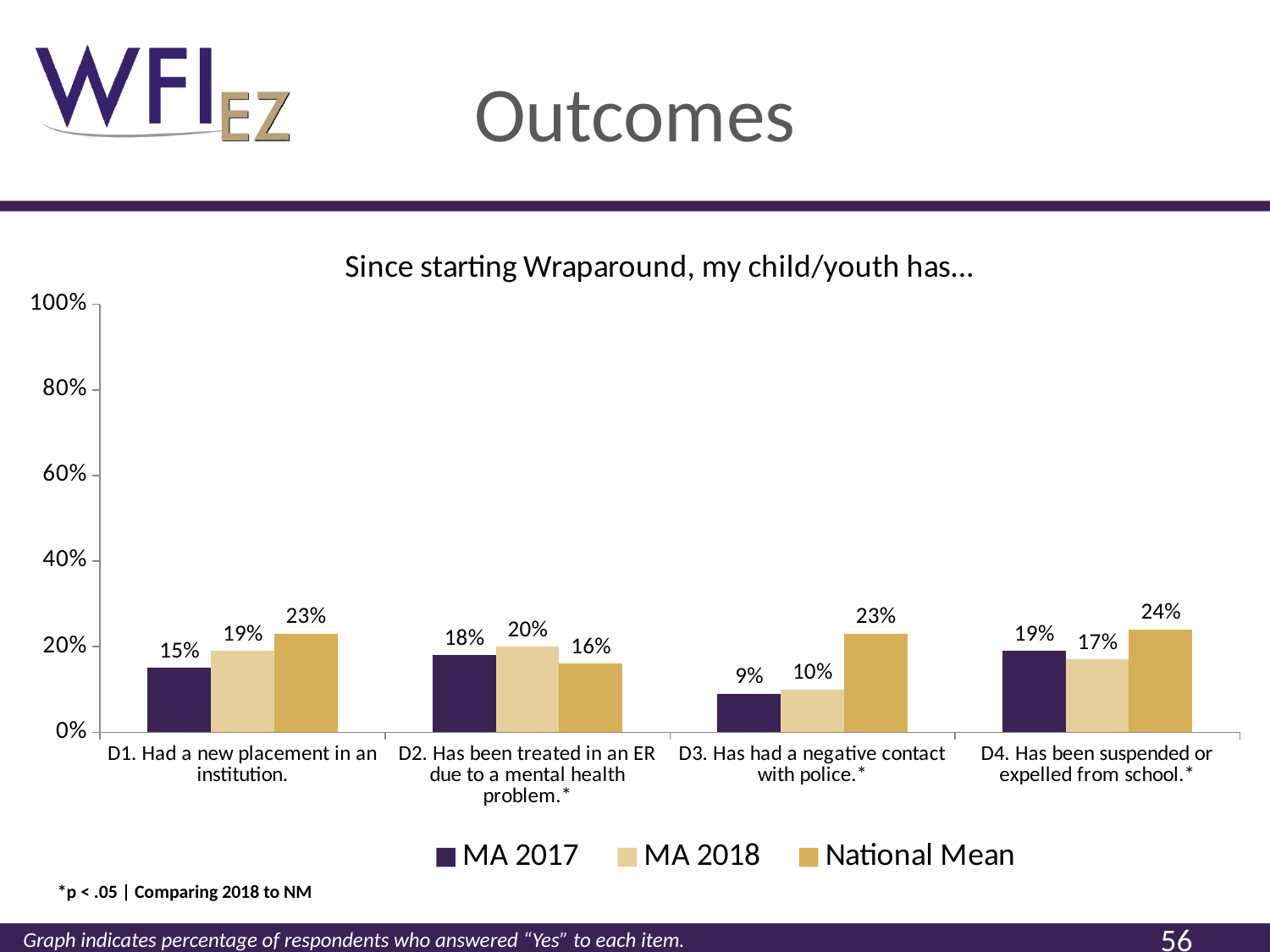
Which category has the highest National Mean value? D4. Has been suspended or expelled from school. How many categories are shown on the x axis? 4 What is the National Mean value for D3. Has had a negative contact with police? 23% What kind of chart is shown on the slide? Bar chart For D2. Has been treated in an ER due to a mental health problem, which is larger: MA 2018 or National Mean? MA 2018 What is the difference between the National Mean and MA 2018 values for D3. Has had a negative contact with police? 13% Is the MA 2017 value for D3. Has had a negative contact with police greater or less than 20%? less What is the title of the chart? Since starting Wraparound, my child/youth has... Which category has the lowest MA 2017 value? D3. Has had a negative contact with police. How many series does the legend list? 3 What is the MA 2017 value for D1. Had a new placement in an institution? 15% What is the MA 2018 value for D4. Has been suspended or expelled from school? 17%